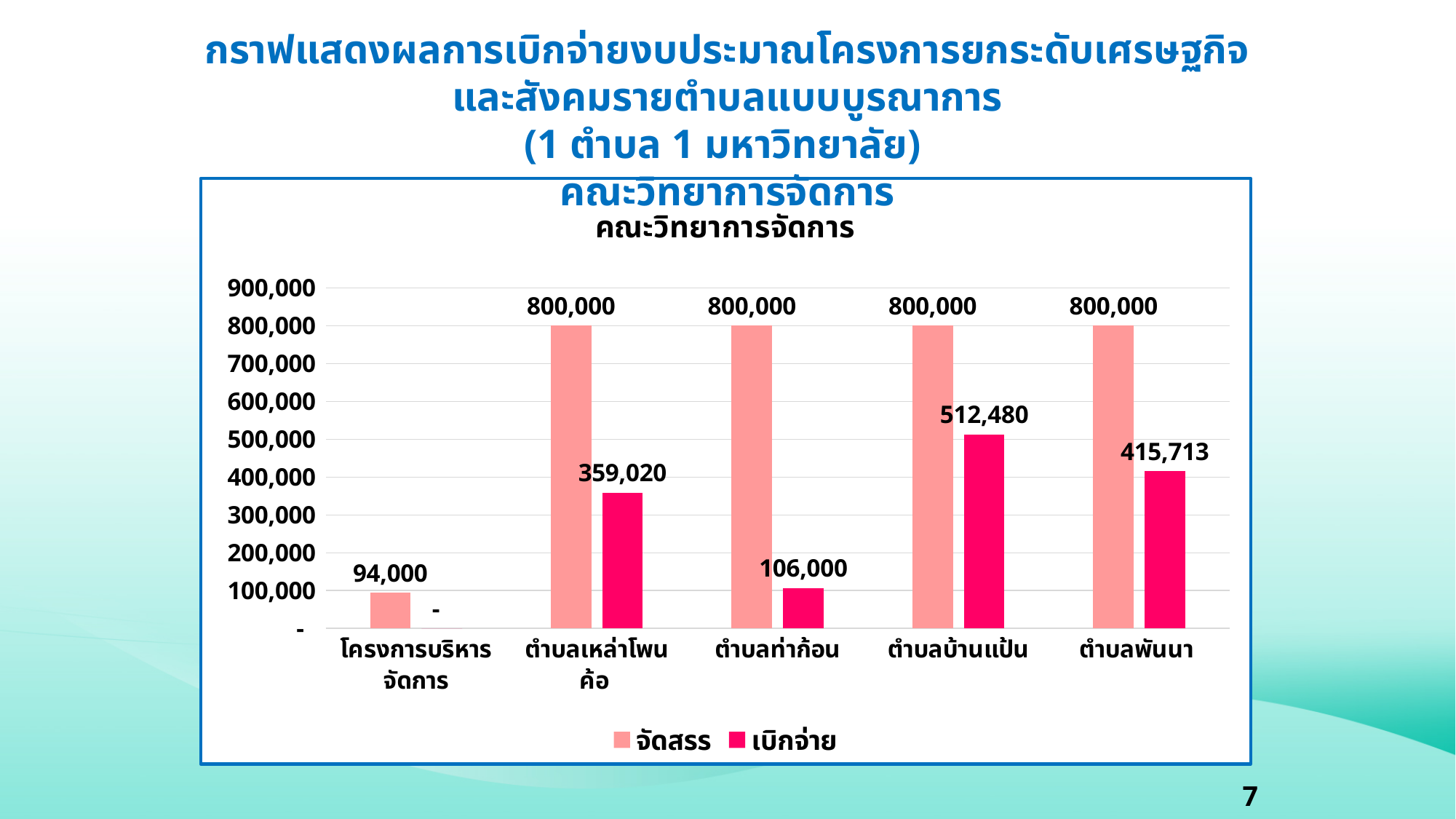
What is the เบิกจ่าย value for ตำบลบ้านแป้น? 512,480 What type of chart is shown on the slide? bar chart What is the จัดสรร value for ตำบลเหล่าโพนค้อ? 800,000 What is the title of the chart? คณะวิทยาการจัดการ What is the จัดสรร value for โครงการบริหารจัดการ? 94,000 How many categories are shown on the x axis? 5 Which category has the highest เบิกจ่าย value? ตำบลบ้านแป้น What is the เบิกจ่าย value for ตำบลท่าก้อน? 106,000 What is the difference between the จัดสรร and เบิกจ่าย values for ตำบลพันนา? 384,287 How many series does the legend list? 2 Which category has the lowest จัดสรร value? โครงการบริหารจัดการ Which is larger: the เบิกจ่าย value for ตำบลเหล่าโพนค้อ or for ตำบลพันนา? ตำบลพันนา